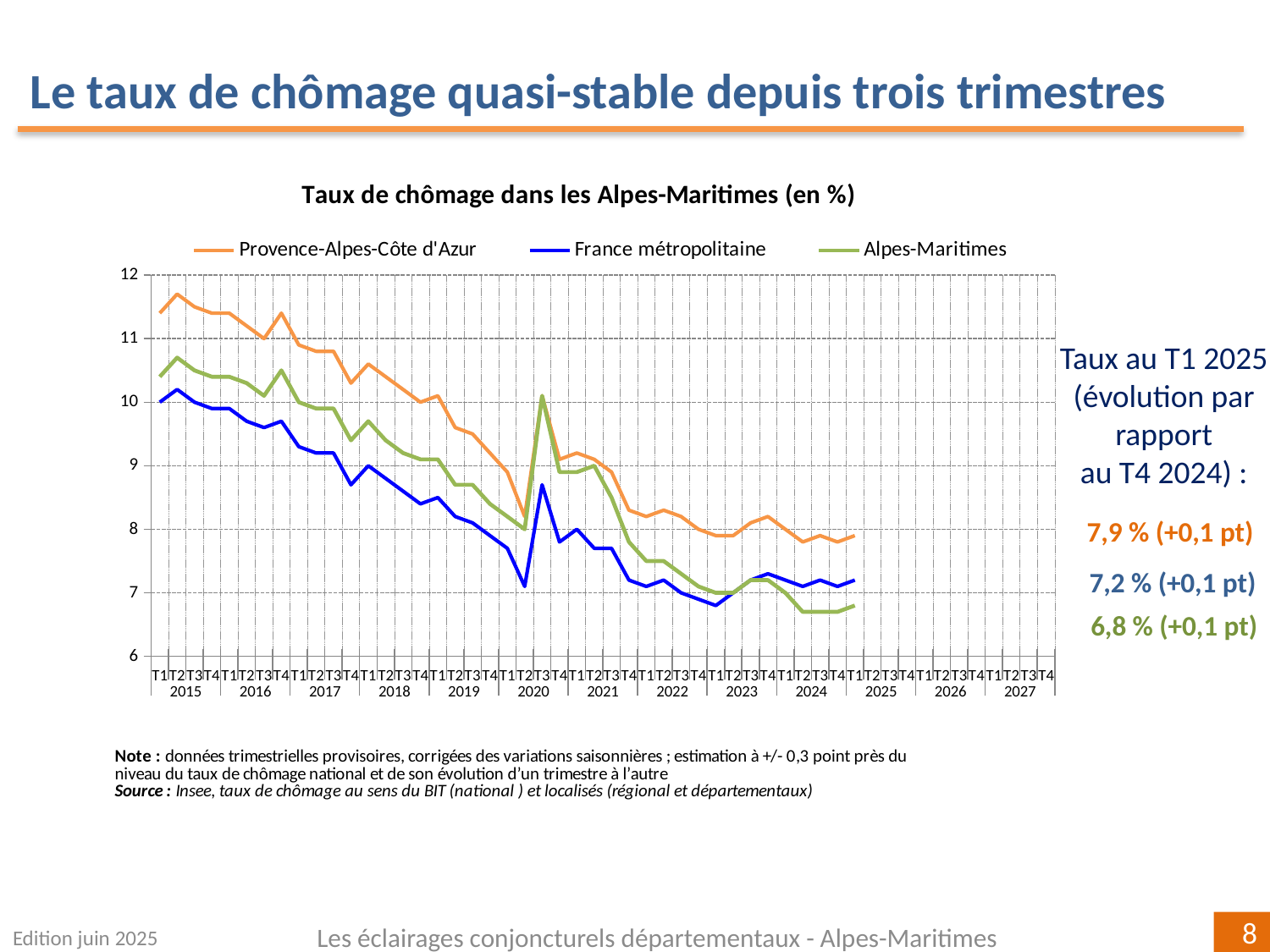
What kind of chart is shown on the slide? Line chart What is the unemployment rate for Alpes-Maritimes at T1 2025? 6,8 % Overall from 2015 to 2025, does the Alpes-Maritimes unemployment rate rise or fall? Fall Which series has the highest value at T1 2025? Provence-Alpes-Côte d'Azur What is the unemployment rate for France métropolitaine at T1 2025? 7,2 % By how much did the Alpes-Maritimes rate change at T1 2025 compared with T4 2024? +0,1 pt What is the difference between the Provence-Alpes-Côte d'Azur rate and the Alpes-Maritimes rate at T1 2025? 1,1 pt At T1 2025, which is higher: France métropolitaine or Alpes-Maritimes? France métropolitaine What is the title of the chart? Taux de chômage dans les Alpes-Maritimes (en %) Is the value for Provence-Alpes-Côte d'Azur at T1 2015 greater or less than 11? greater What is the unemployment rate for Provence-Alpes-Côte d'Azur at T1 2025? 7,9 % How many series does the legend of the chart list? 3